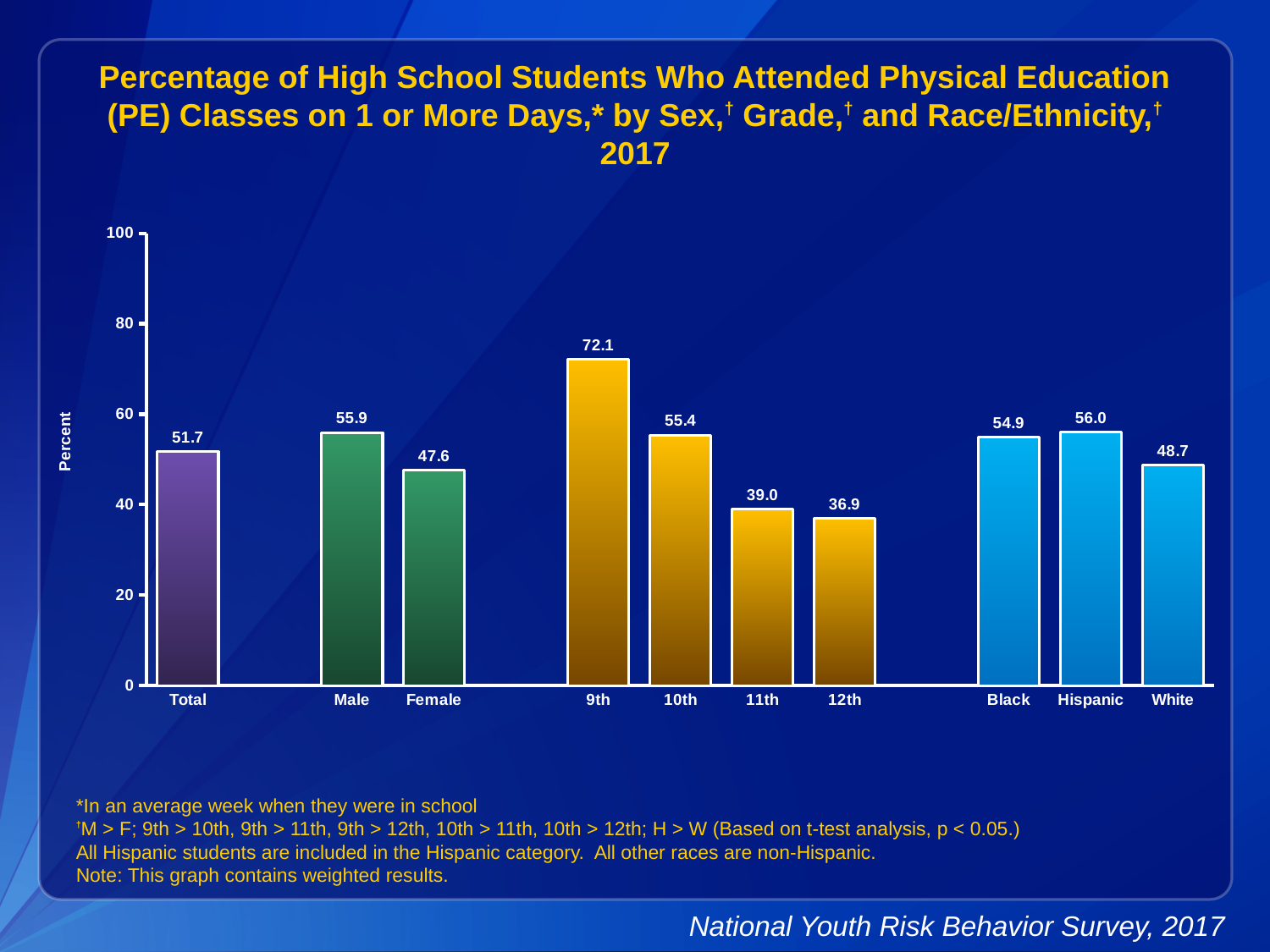
How many categories are shown on the x axis? 10 What is the value for Female? 47.6 What is the difference between the values for Male and Female? 8.3 Which is larger, the value for Black or the value for White? Black What kind of chart is shown on the slide? bar chart What is the value for Total? 51.7 What is the value for 12th grade? 36.9 What is the value for Hispanic? 56.0 Which category has the highest value? 9th Which category has the lowest value? 12th What is the difference between the values for 9th and 10th grade? 16.7 Is the value for 11th grade greater or less than 40? less